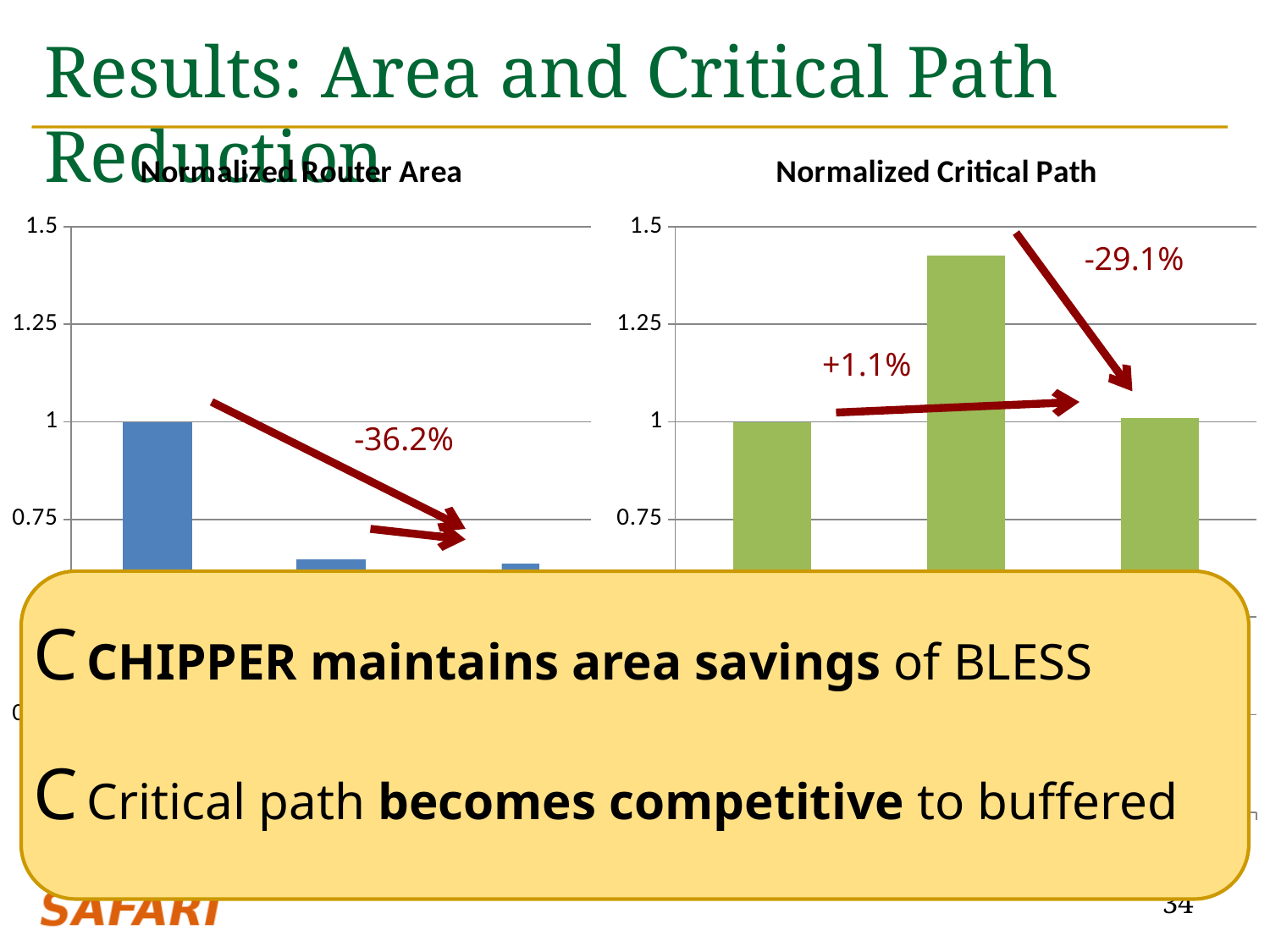
In the Normalized Critical Path chart, which bar is the highest? the second (middle) bar In the Normalized Critical Path chart, is the value of the middle bar greater or less than 1.25? greater What percentage change is annotated on the Normalized Router Area chart? -36.2% In the Normalized Router Area chart, what is the value of the first (leftmost) bar? 1 In the Normalized Critical Path chart, what is the value of the first (leftmost) bar? 1 What kind of chart is the Normalized Router Area chart? bar chart What percentage change is annotated between the second and third bars on the Normalized Critical Path chart? -29.1% How many bars are plotted in the Normalized Critical Path chart? 3 In the Normalized Router Area chart, is the value of the middle bar greater or less than 0.75? less In the Normalized Router Area chart, which bar is the highest? the first (leftmost) bar How many bars are plotted in the Normalized Router Area chart? 3 In the Normalized Critical Path chart, which is larger, the second bar or the third bar? the second bar